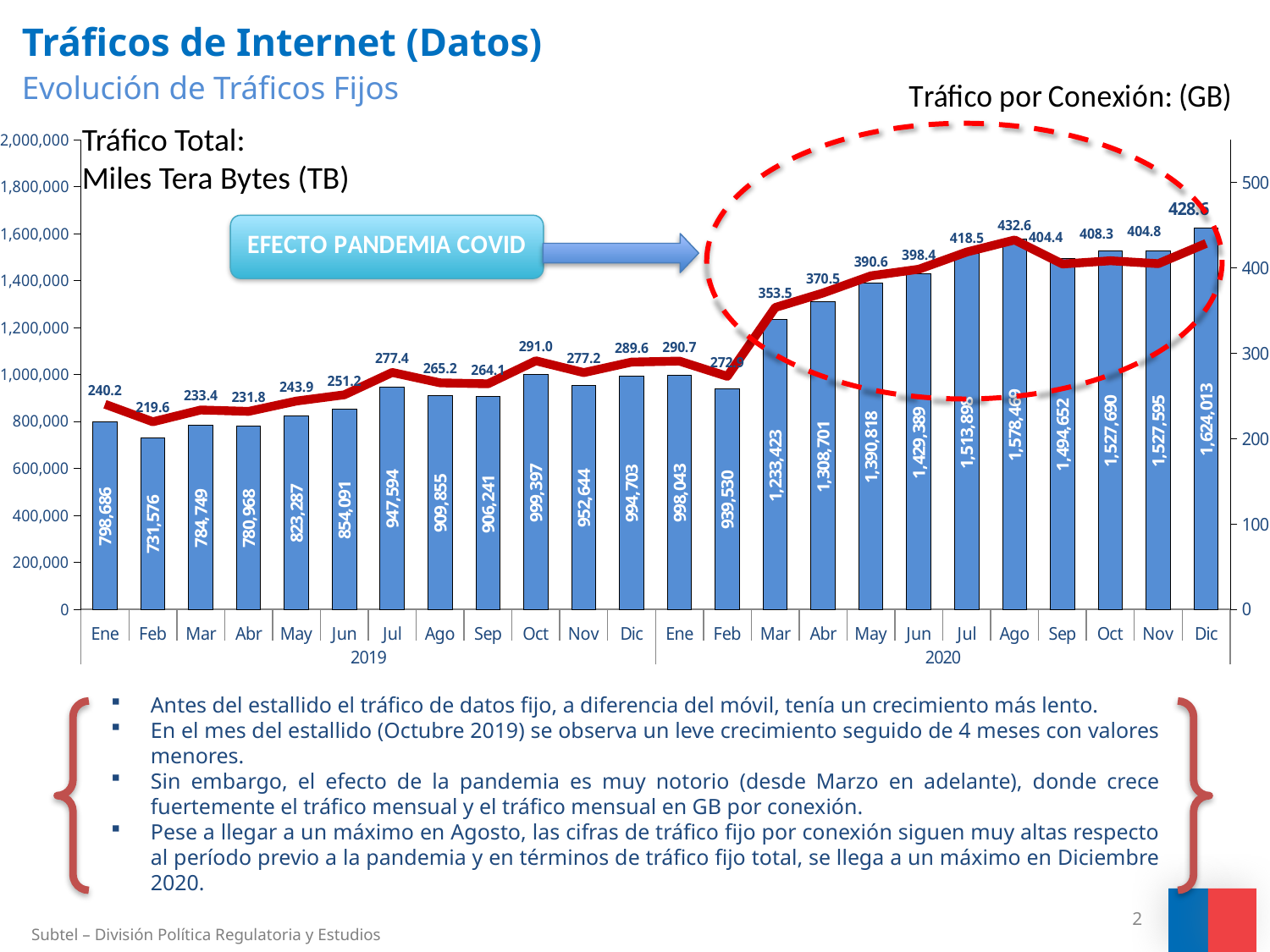
Which month has the lowest total traffic bar? Feb 2019 What text is shown in the callout box with the arrow pointing to the 2020 data? EFECTO PANDEMIA COVID Is the total traffic bar for Jul 2020 greater or less than 1,400,000? greater What type of chart is used to show the total traffic values? Bar chart What is the difference in total traffic between Mar 2020 and Feb 2020? 293,893 How many monthly bars are plotted in the chart? 24 Which month has the lowest Tráfico por Conexión (GB) value on the line? Feb 2019 What is the Tráfico por Conexión (GB) value for Ago 2020? 432.6 Which is larger, the total traffic for Oct 2019 or for Dic 2019? Oct 2019 Which month has the highest total traffic bar? Dic 2020 What is the total fixed traffic (Tráfico Total) value for Dic 2020? 1,624,013 What is the total traffic bar value for Feb 2019? 731,576